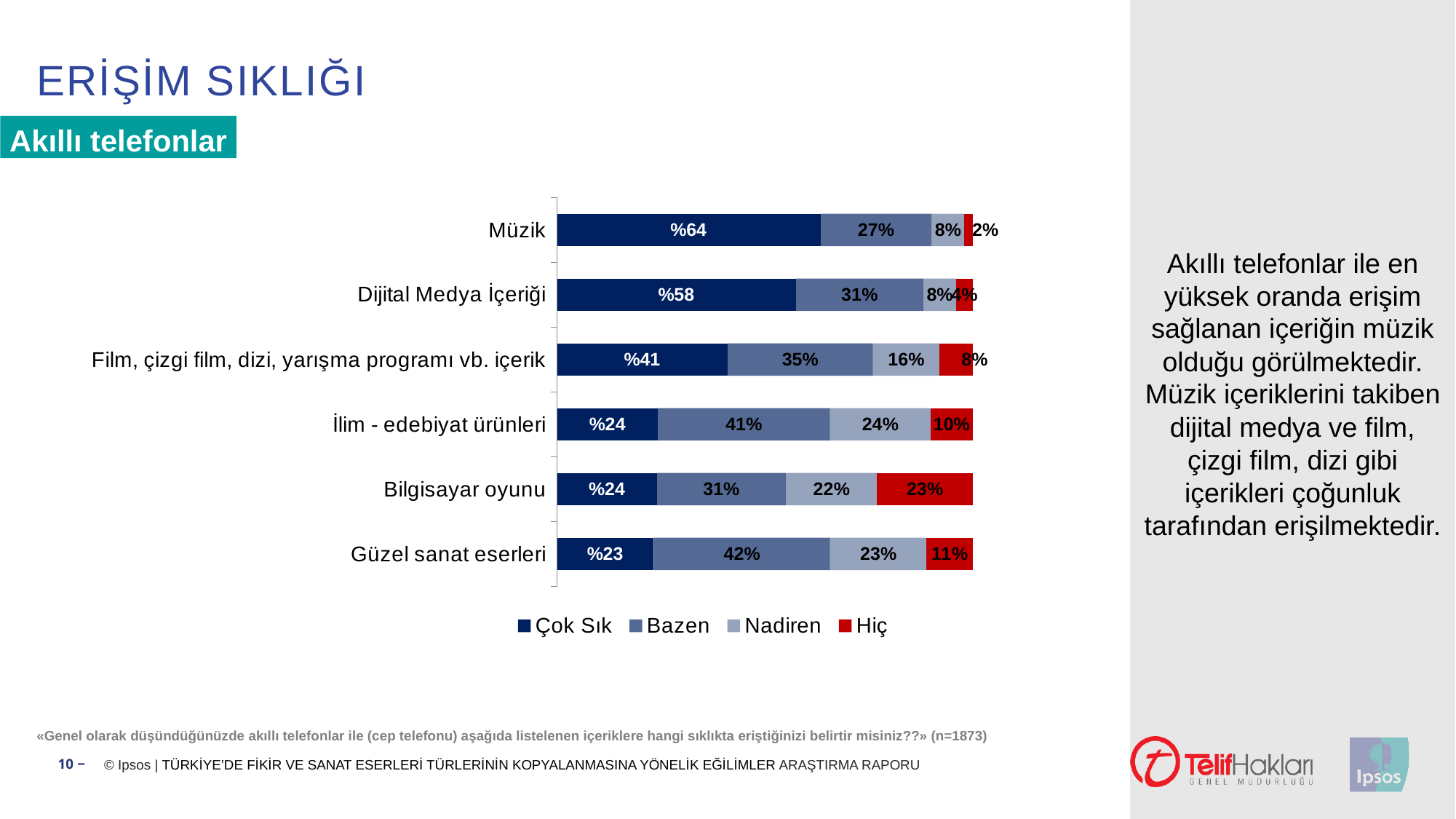
How many categories are shown on the chart? 6 What is the "Hiç" value for Bilgisayar oyunu? 23% What kind of chart is shown on the slide? Stacked bar chart What is the "Nadiren" value for Film, çizgi film, dizi, yarışma programı vb. içerik? 16% What is the "Bazen" value for Güzel sanat eserleri? 42% Which is larger: the "Bazen" value for İlim - edebiyat ürünleri or the "Bazen" value for Bilgisayar oyunu? İlim - edebiyat ürünleri Which category has the highest "Çok Sık" value? Müzik Which series is shown in red in the legend? Hiç What is the "Çok Sık" value for Müzik? %64 Which category has the lowest "Hiç" value? Müzik What is the difference between the "Çok Sık" values for Müzik and Dijital Medya İçeriği? 6 percentage points How many series does the legend list? 4